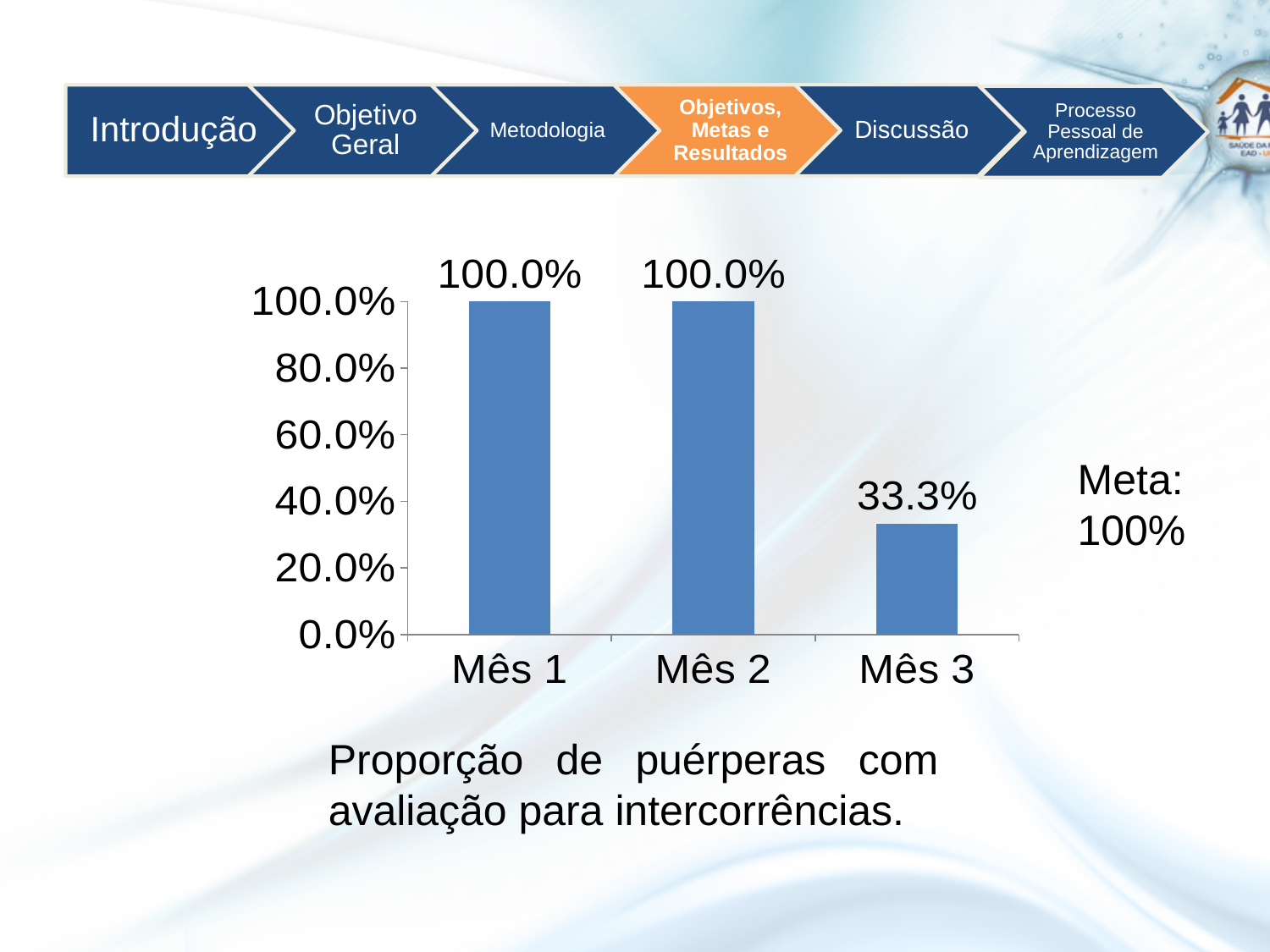
Do the values rise or fall from Mês 2 to Mês 3? fall How many categories are shown on the x axis? 3 What is the value for Mês 3? 33.3% What is the value for Mês 2? 100.0% Which is larger, the value for Mês 1 or the value for Mês 3? Mês 1 What is the caption below the chart? Proporção de puérperas com avaliação para intercorrências. What is the value for Mês 1? 100.0% What kind of chart is shown on the slide? bar chart What is the target (Meta) stated next to the chart? 100% Is the value for Mês 3 greater or less than 40.0%? less What is the difference between the values for Mês 2 and Mês 3? 66.7% Which month has the lowest value? Mês 3